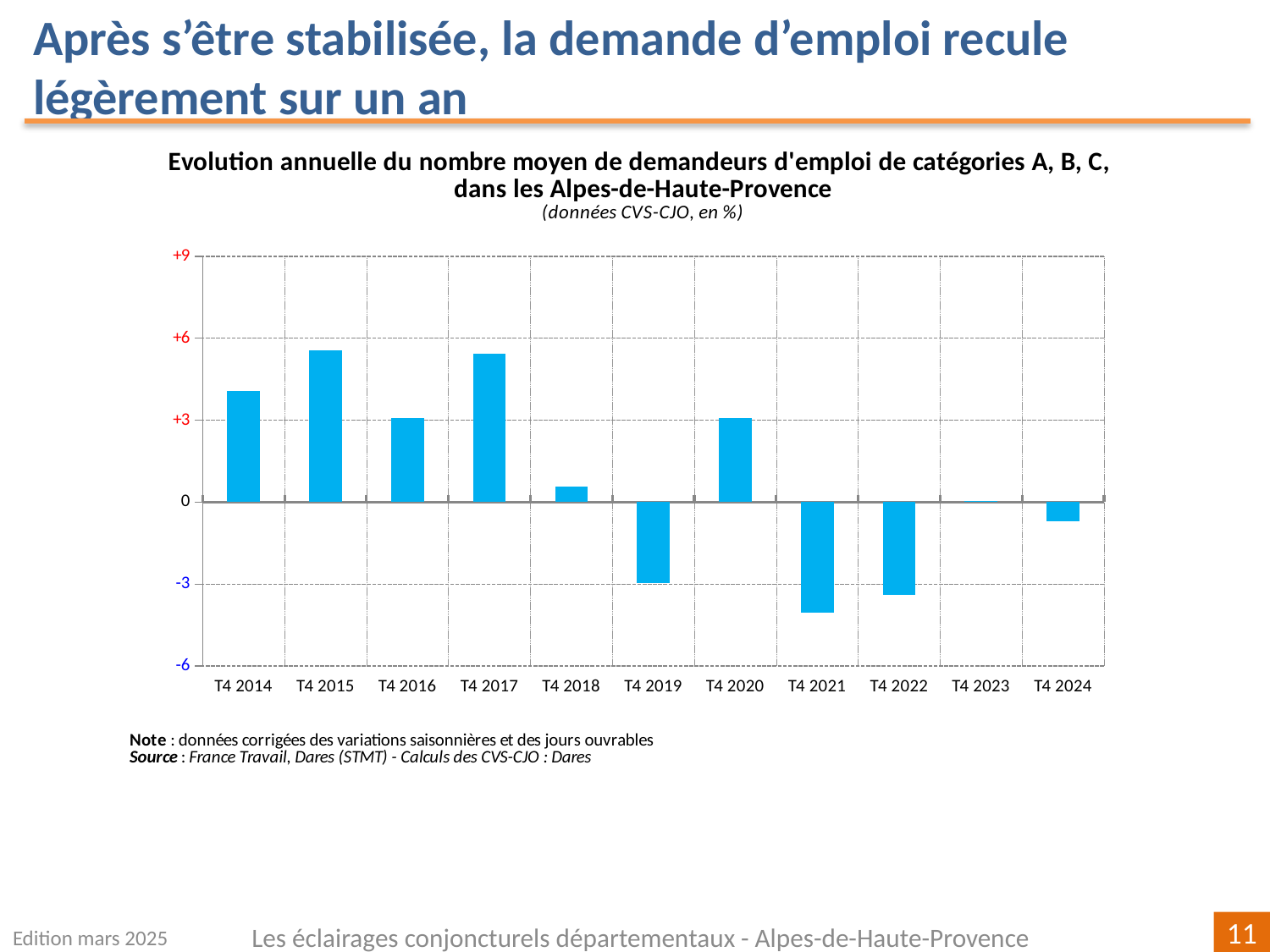
Is the value for T4 2015 greater or less than +6? less Is the value for T4 2021 greater or less than -3? less Which is larger, the value for T4 2022 or the value for T4 2021? T4 2022 How many periods (categories) are shown on the x axis of the chart? 11 What colour are the bars in the chart? blue Is the value for T4 2018 greater or less than +3? less What is the title of the chart? Evolution annuelle du nombre moyen de demandeurs d'emploi de catégories A, B, C, dans les Alpes-de-Haute-Provence What kind of chart is shown on the slide? bar chart Which is larger, the value for T4 2014 or the value for T4 2016? T4 2014 Which period has the lowest value in the chart? T4 2021